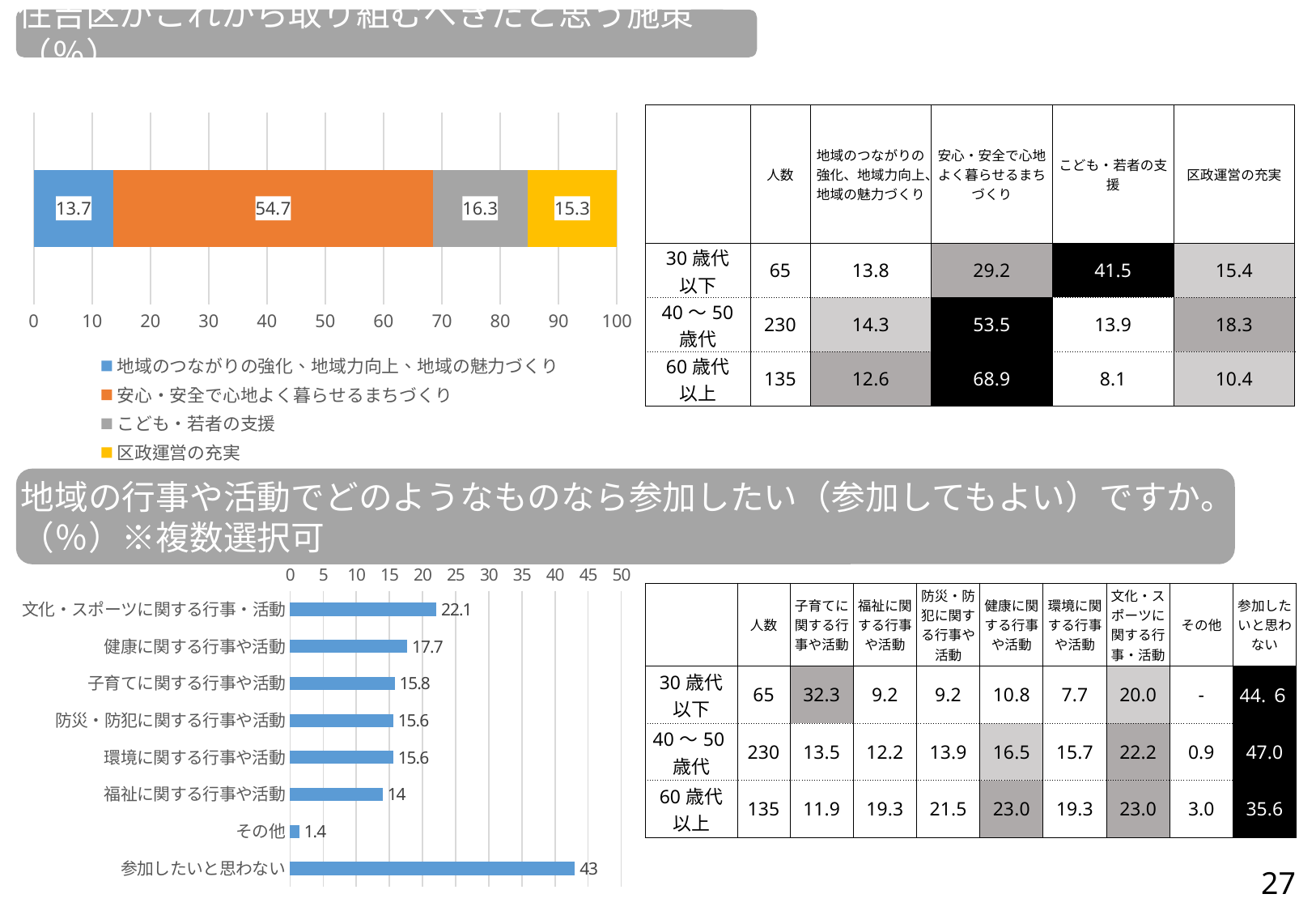
In the top stacked bar chart, what is the total of all four segments? 100 In the top stacked bar chart, what is the value for 区政運営の充実? 15.3 In the bottom chart (地域の行事や活動でどのようなものなら参加したい), which category has the lowest value? その他 In the top stacked bar chart, what is the value for 安心・安全で心地よく暮らせるまちづくり? 54.7 In the bottom chart (地域の行事や活動でどのようなものなら参加したい), what is the difference between 文化・スポーツに関する行事・活動 and 福祉に関する行事や活動? 8.1 In the top stacked bar chart, which segment has the smallest value? 地域のつながりの強化、地域力向上、地域の魅力づくり In the top stacked bar chart, what colour is the segment for こども・若者の支援? Gray In the bottom chart (地域の行事や活動でどのようなものなら参加したい), what is the value for 健康に関する行事や活動? 17.7 In the top stacked bar chart, which segment has the largest value? 安心・安全で心地よく暮らせるまちづくり In the bottom chart (地域の行事や活動でどのようなものなら参加したい), how many categories are plotted? 8 In the bottom chart (地域の行事や活動でどのようなものなら参加したい), which category has the highest value? 参加したいと思わない In the top stacked bar chart, how many series does the legend list? 4